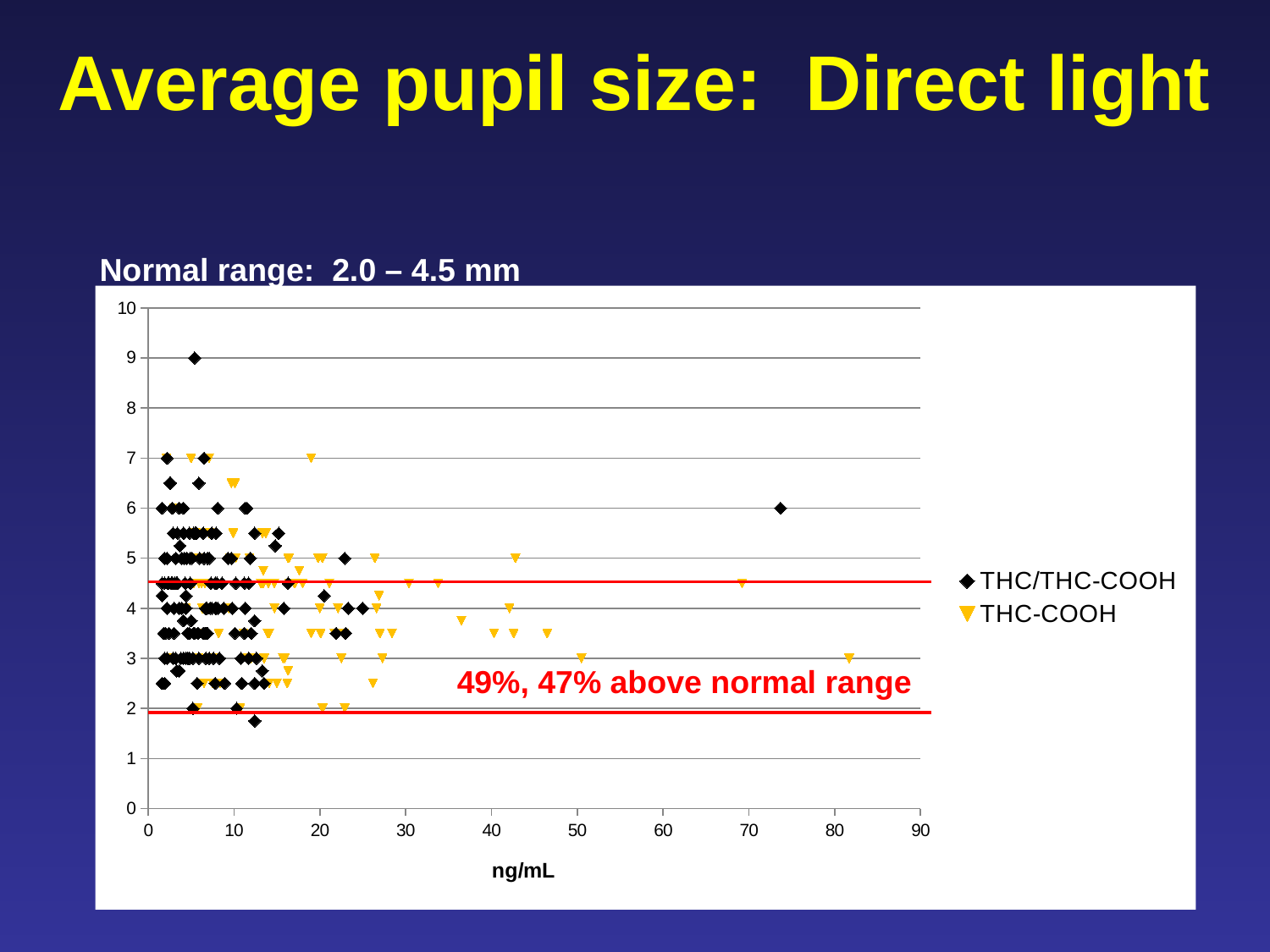
How many series does the legend list? 2 Is the highest THC/THC-COOH point greater or less than 8? greater Is the y value of the rightmost THC-COOH point (near 82 ng/mL) greater or less than 4? less What kind of chart is shown on the slide? scatter chart Is the y value of the rightmost THC/THC-COOH point (near 74 ng/mL) greater or less than 5? greater What are the two series named in the legend? THC/THC-COOH and THC-COOH What normal range is stated above the chart? 2.0 – 4.5 mm What is the y-axis value of the highest THC/THC-COOH point? 9 Which series contains the point with the highest y value, THC/THC-COOH or THC-COOH? THC/THC-COOH What is the label on the x axis of the chart? ng/mL Which series contains the point farthest to the right on the x axis, THC/THC-COOH or THC-COOH? THC-COOH